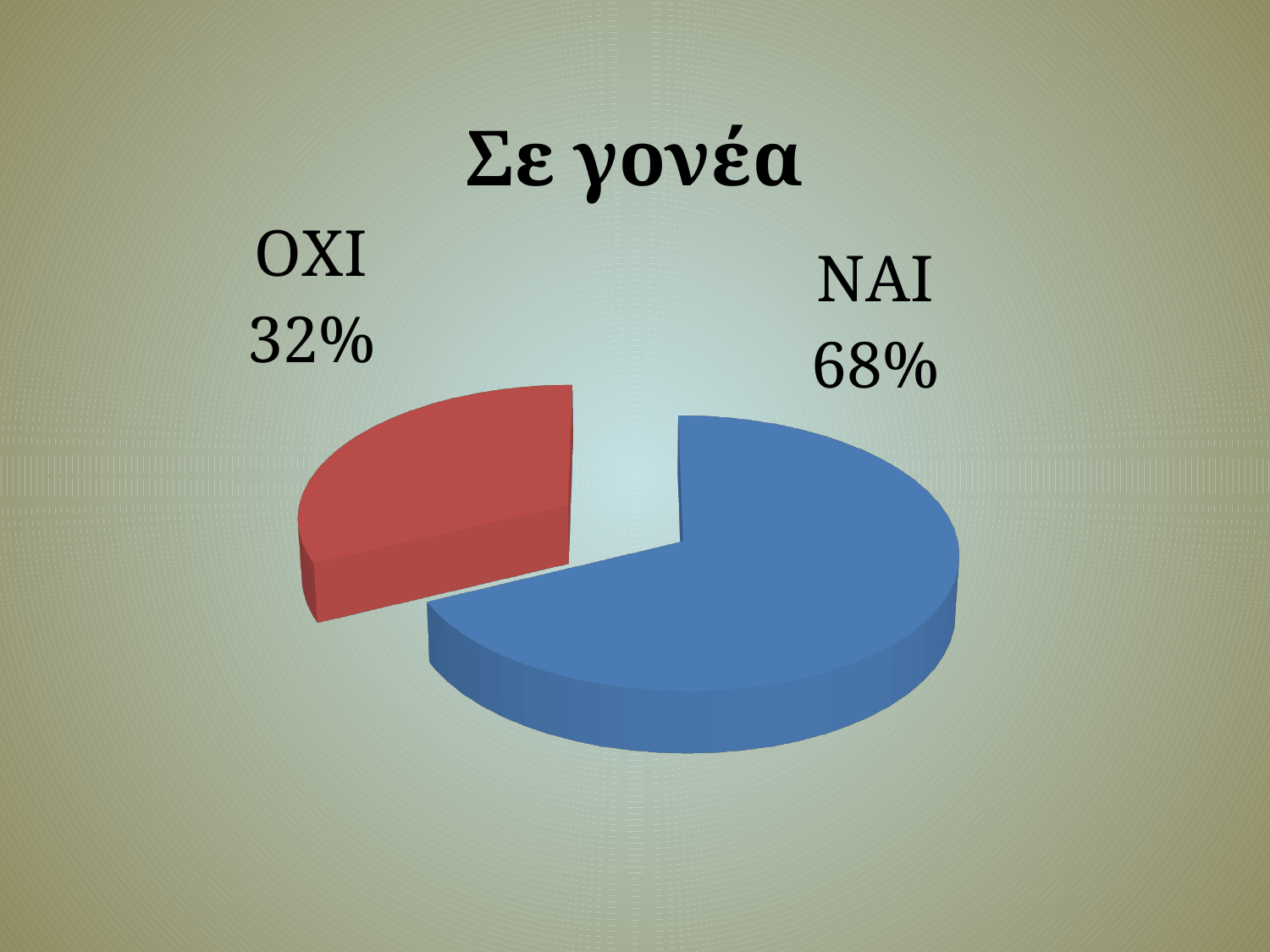
What type of chart is shown on the slide? pie chart How many slices does the pie chart have? 2 What percentage is shown for ΟΧΙ? 32% Which slice is the smallest? ΟΧΙ What colour is the ΝΑΙ slice? blue What share of the pie does ΟΧΙ represent? 32% Which is larger, ΝΑΙ or ΟΧΙ? ΝΑΙ What percentage is shown for ΝΑΙ? 68% What is the title of the chart? Σε γονέα Which slice is the largest? ΝΑΙ What is the difference between the ΝΑΙ and ΟΧΙ percentages? 36%